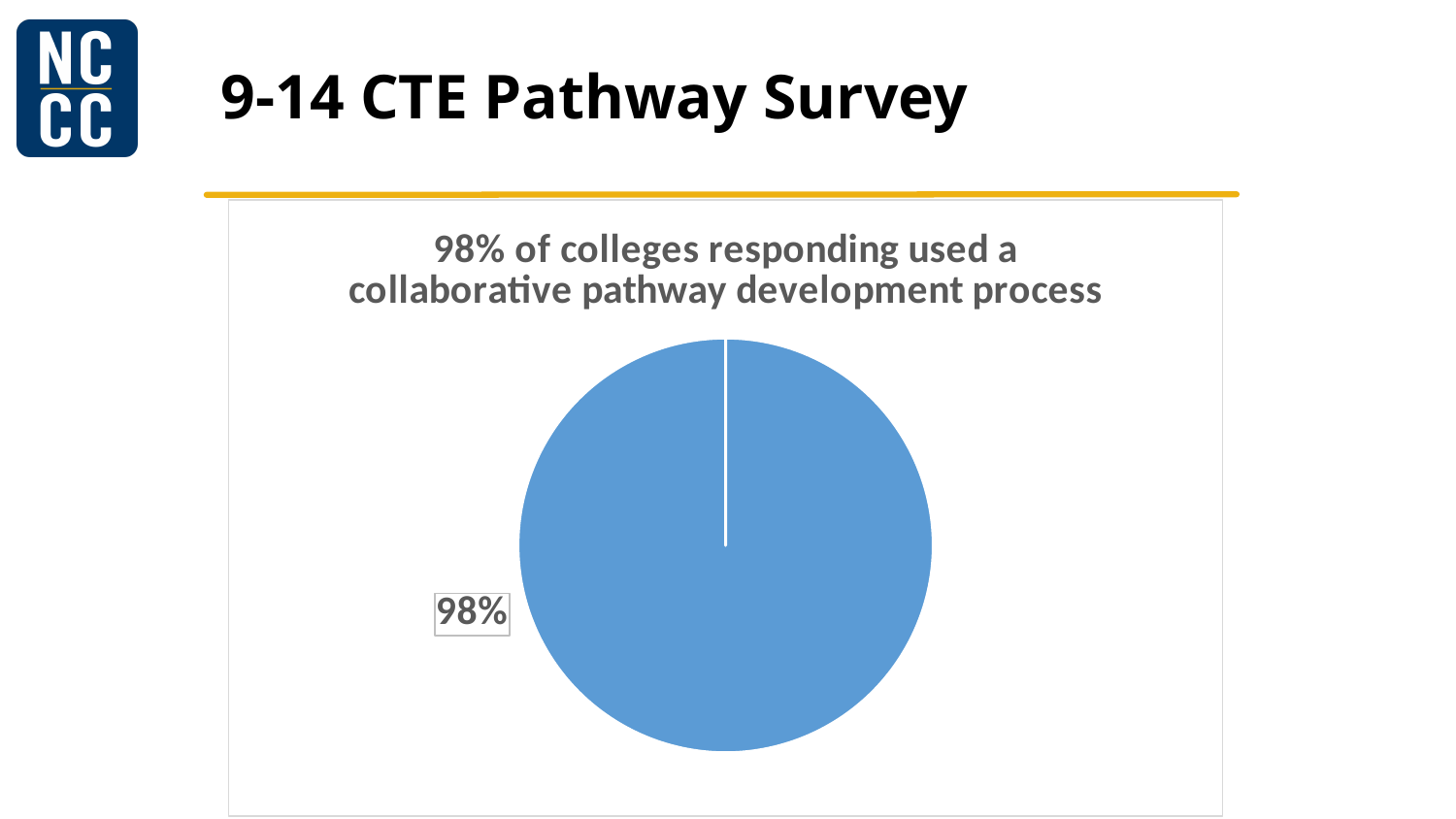
What colour is the large slice of the pie chart? blue What percentage is printed as the data label on the large slice of the pie chart? 98% What is the title of the pie chart? 98% of colleges responding used a collaborative pathway development process Is the value of the labeled slice greater or less than 50%? greater What share of the pie does the labeled slice represent? 98% What kind of chart is shown on the slide? pie chart